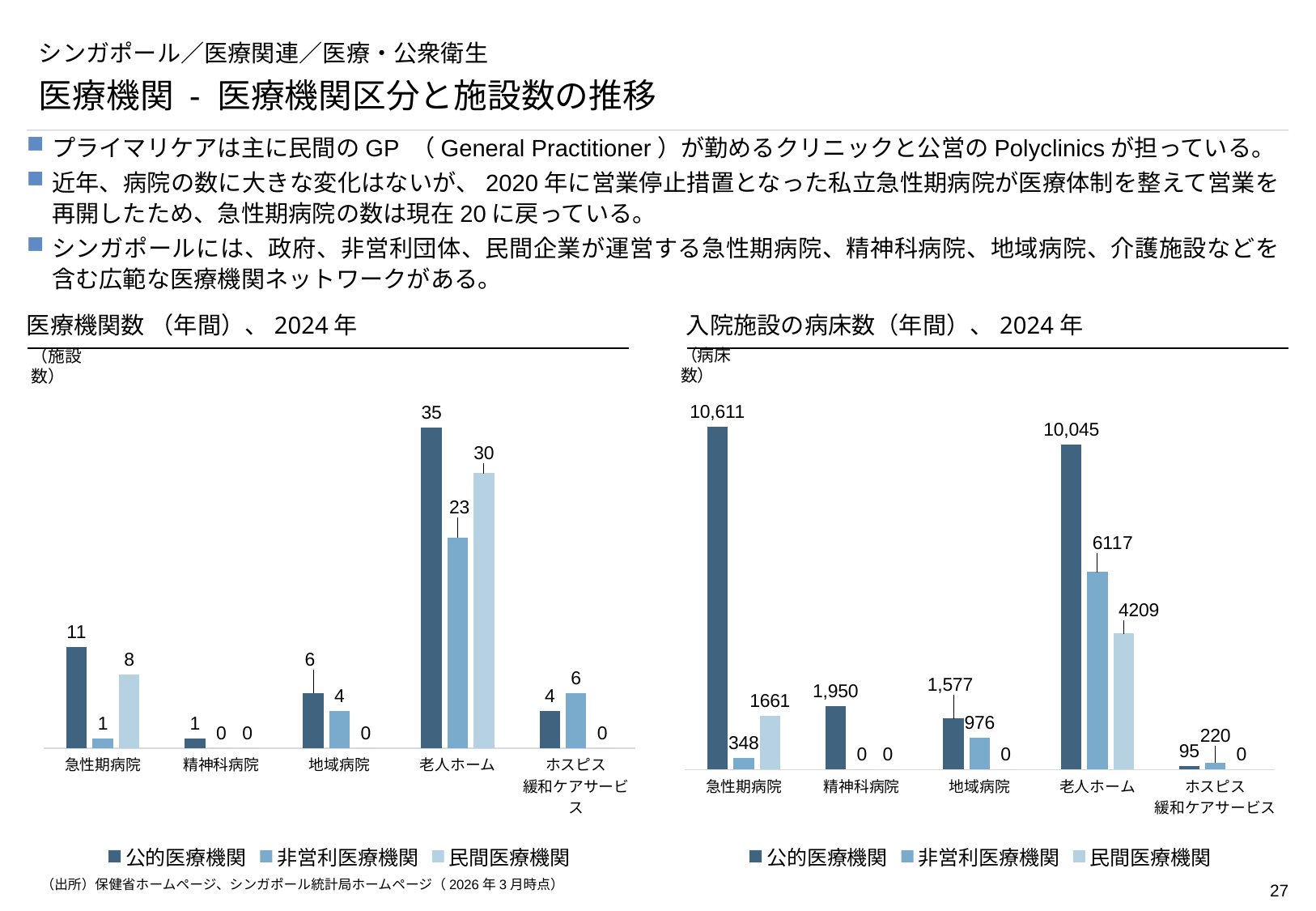
In the chart titled 入院施設の病床数（年間）、2024年, what is the difference between 公的医療機関 and 民間医療機関 in the 急性期病院 category? 8,950 In the chart titled 入院施設の病床数（年間）、2024年, which category has the lowest value for 公的医療機関? ホスピス緩和ケアサービス How many series does the legend list in the chart titled 入院施設の病床数（年間）、2024年? 3 In the chart titled 医療機関数（年間）、2024年, which category has the highest value for 非営利医療機関? 老人ホーム In the chart titled 入院施設の病床数（年間）、2024年, what is the value for 非営利医療機関 in the 老人ホーム category? 6117 In the chart titled 医療機関数（年間）、2024年, what is the value for 民間医療機関 in the 急性期病院 category? 8 What kind of chart is the chart titled 医療機関数（年間）、2024年? Bar chart In the chart titled 入院施設の病床数（年間）、2024年, what is the value for 公的医療機関 in the 急性期病院 category? 10,611 In the chart titled 医療機関数（年間）、2024年, what is the difference between 公的医療機関 and 非営利医療機関 in the 老人ホーム category? 12 In the chart titled 医療機関数（年間）、2024年, how many categories are shown on the x axis? 5 In the chart titled 医療機関数（年間）、2024年, which is larger in the ホスピス緩和ケアサービス category: 公的医療機関 or 非営利医療機関? 非営利医療機関 In the chart titled 医療機関数（年間）、2024年, what is the value for 公的医療機関 in the 老人ホーム category? 35